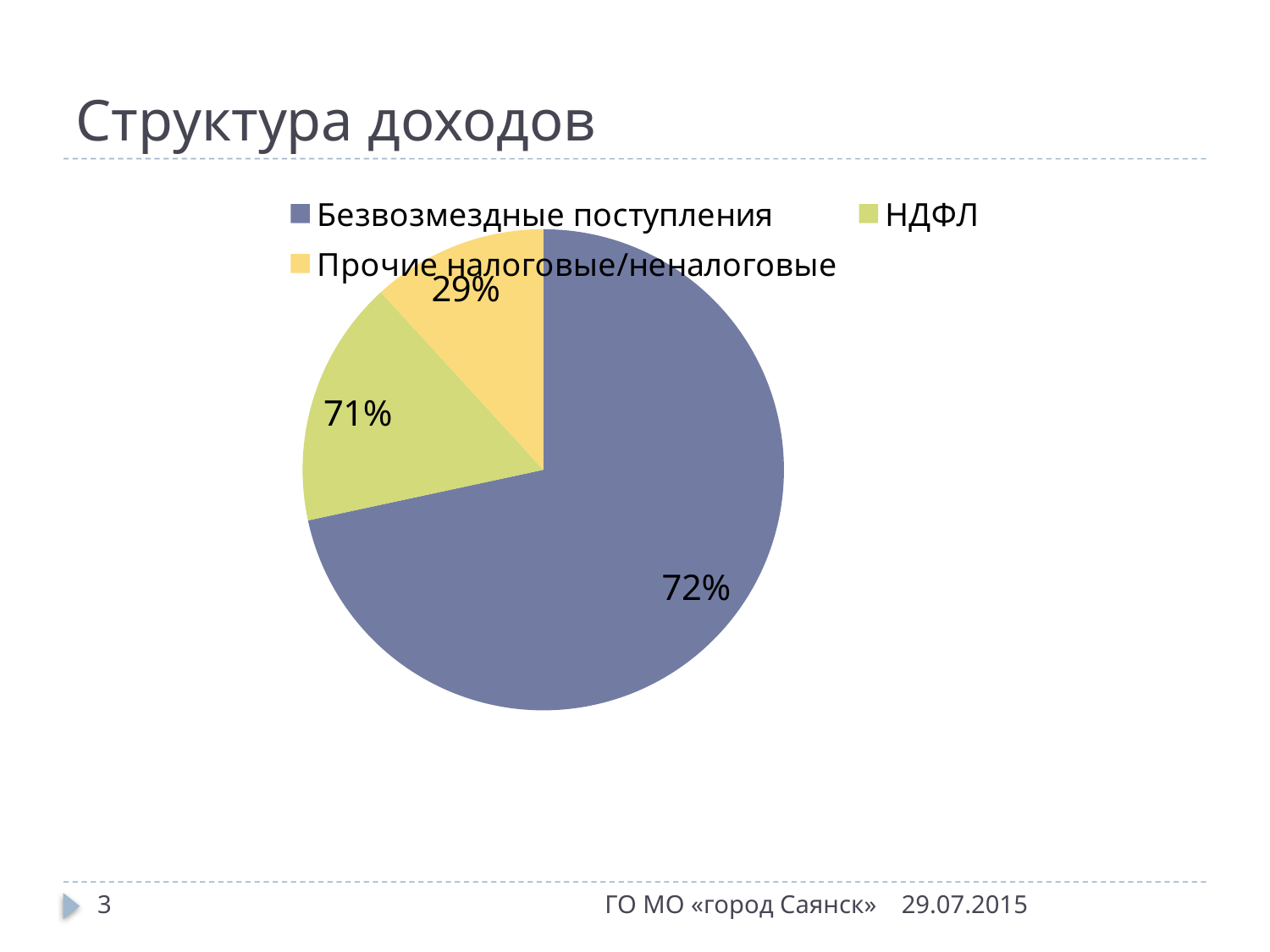
How many categories does the legend list? 3 What colour is the slice for НДФЛ? Green Which category has the smallest slice of the pie? Прочие налоговые/неналоговые Which slice is larger, НДФЛ or Прочие налоговые/неналоговые? НДФЛ Which category has the largest slice of the pie? Безвозмездные поступления What is the difference between the labelled values for НДФЛ and Прочие налоговые/неналоговые? 42 percentage points What percentage is labelled on the slice for Прочие налоговые/неналоговые? 29% What type of chart is shown on the slide? Pie chart What percentage is labelled on the slice for Безвозмездные поступления? 72% What is the title of the chart? Структура доходов How many slices does the pie chart have? 3 What percentage is labelled on the slice for НДФЛ? 71%